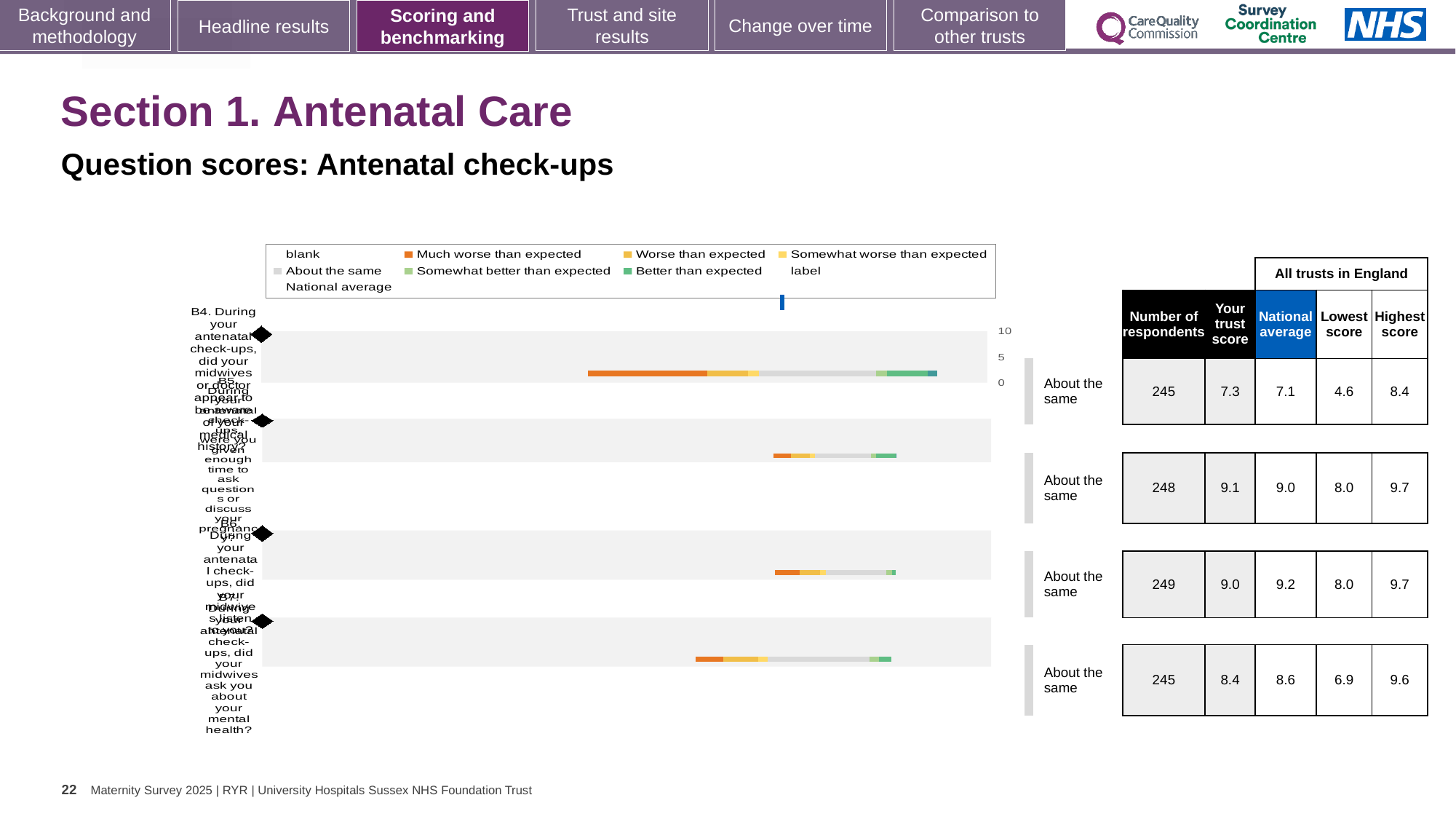
Which row in the table has the lowest trust score? the first row, B4 (7.3) In the table next to the chart, what is the lowest score for the first row (B4)? 4.6 How many question rows (bars) does the chart show? 4 In the table next to the chart, what is the trust score for the last row (B7, midwives asked about mental health)? 8.4 Which row in the table has the highest trust score? the second row (9.1) In the table next to the chart, what is the number of respondents for the first row (B4, midwives or doctor aware of medical history)? 245 What is the difference between the trust score and the national average for the first row (B4)? 0.2 In the table next to the chart, what is the national average for the first row (B4)? 7.1 In the table next to the chart, what is the highest score for the last row (B7, midwives asked about mental health)? 9.6 What kind of chart is shown on the slide? bar chart For the last row (B7), which is larger: the trust score or the national average? the national average (8.6) In the table next to the chart, what is the trust score for the first row (B4)? 7.3